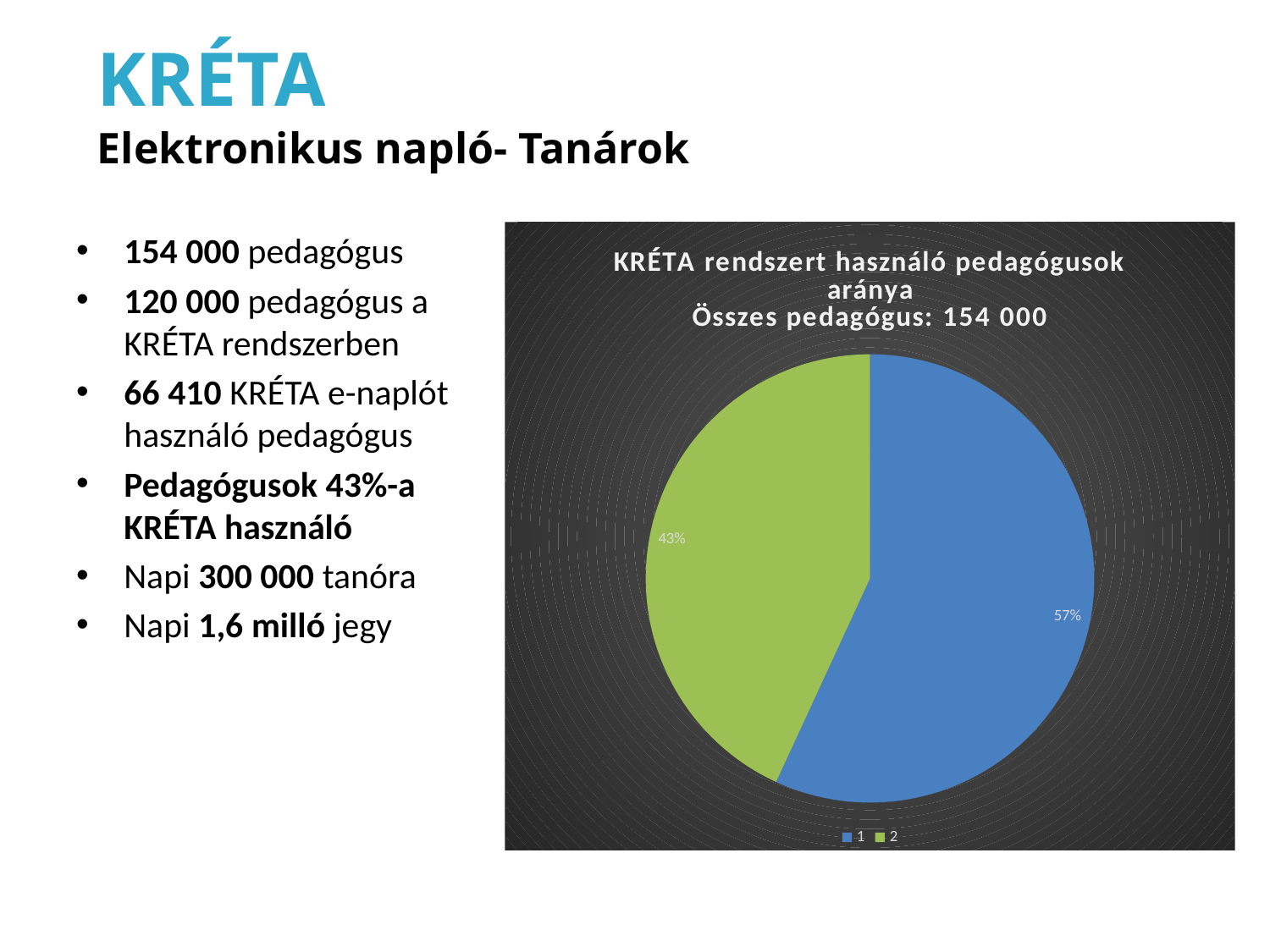
What kind of chart is shown on the slide? pie chart Which slice of the pie chart is the smallest? 2 Which slice of the pie chart is the largest? 1 What percentage is shown for the blue slice (legend entry 1) of the pie chart? 57% Which slice is larger in the pie chart, slice 1 or slice 2? 1 How many entries does the legend of the pie chart list? 2 What share of the pie does the green slice represent? 43% What is the difference in percentage points between the two slices of the pie chart? 14 What percentage is shown for the green slice (legend entry 2) of the pie chart? 43% What is the title of the pie chart? KRÉTA rendszert használó pedagógusok aránya Összes pedagógus: 154 000 What colour is the slice labelled 57% in the pie chart? blue How many slices does the pie chart have? 2